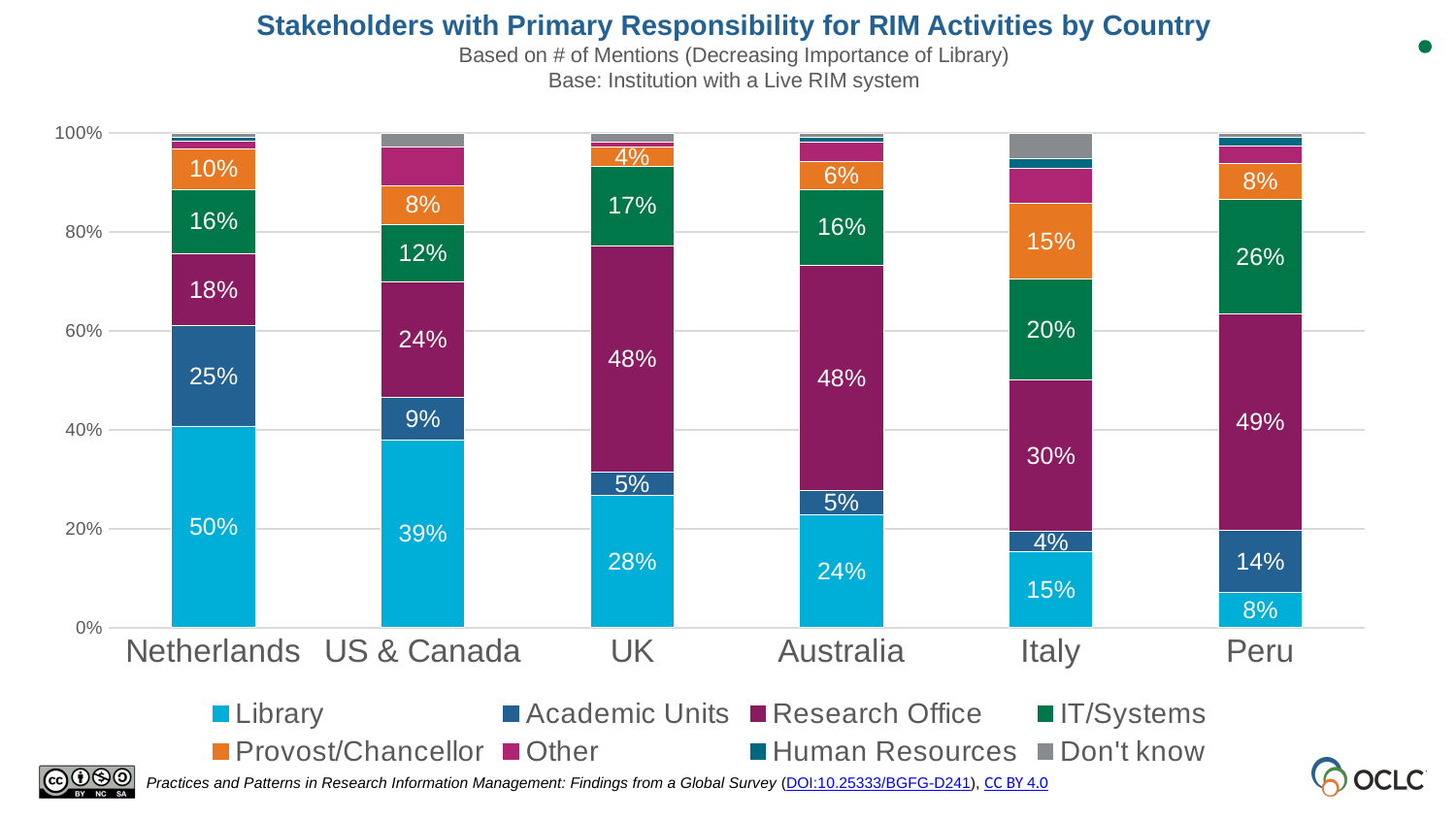
Which country has the lowest Library share? Peru What percentage of mentions does the Library account for in the Netherlands? 50% What is the Academic Units value for US & Canada? 9% Which country has the highest Library share? Netherlands Does the Library share rise or fall moving from left to right across the countries? Fall Which country has the highest IT/Systems share? Peru Which is larger: the Provost/Chancellor share in Italy or in US & Canada? Italy What is the Research Office share for Peru? 49% How many series does the legend list? 8 How many countries are shown on the x axis? 6 What is the IT/Systems value for Italy? 20% What is the difference between the Library share in the Netherlands and in Peru? 42 percentage points